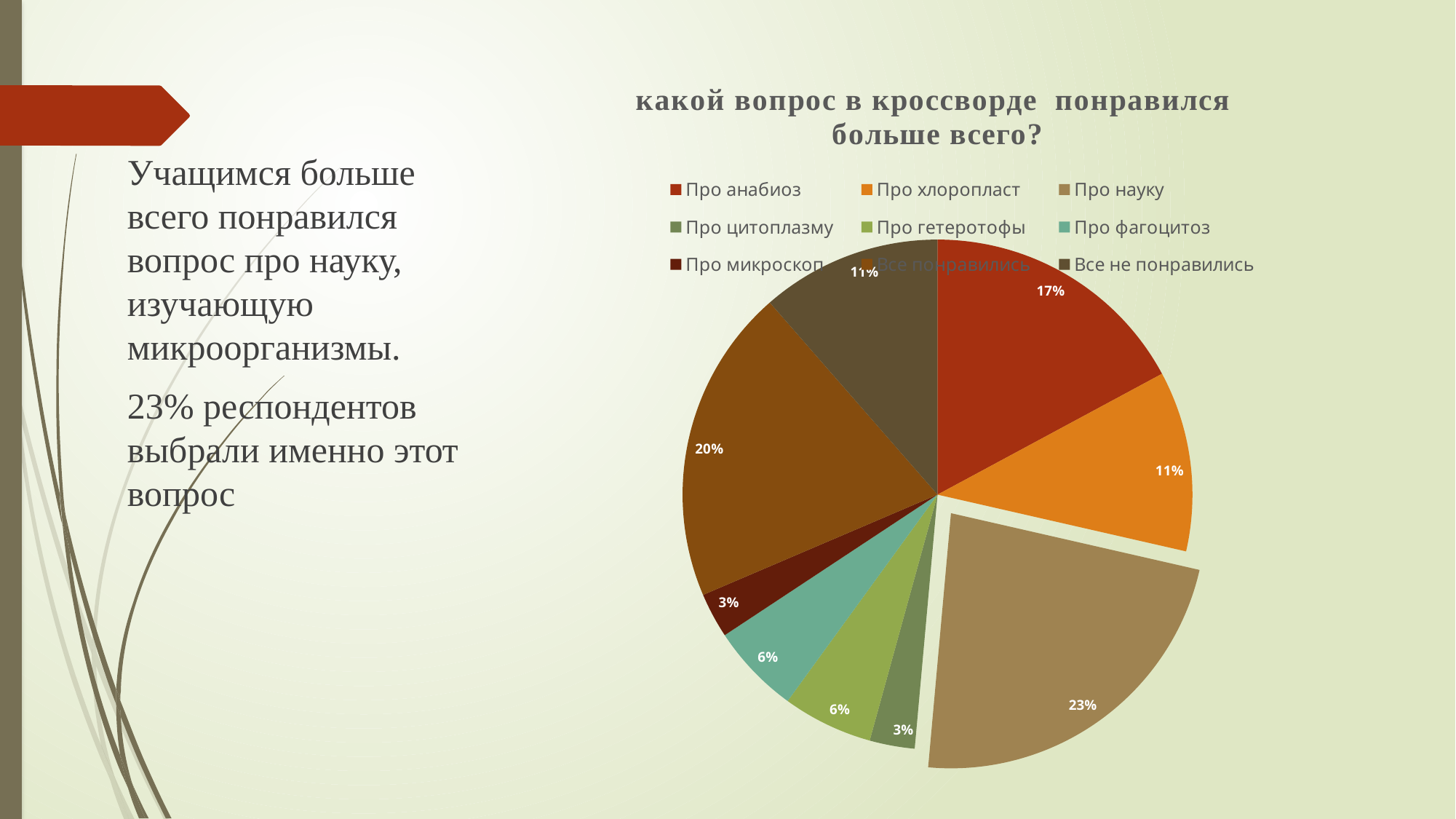
What is the value for "Про фагоцитоз"? 6% What is the difference between the values for "Про науку" and "Все понравились"? 3% What kind of chart is shown on the slide? pie chart What is the value for "Все понравились"? 20% What share of the pie does "Про науку" have? 23% What is the value for "Про микроскоп"? 3% Which category has the largest share of the pie? Про науку What is the title of the chart? какой вопрос в кроссворде понравился больше всего? Which slice is pulled out (exploded) from the pie? Про науку What is the value for "Про анабиоз"? 17% How many categories does the pie chart have? 9 Which is larger, "Про анабиоз" or "Про хлоропласт"? Про анабиоз